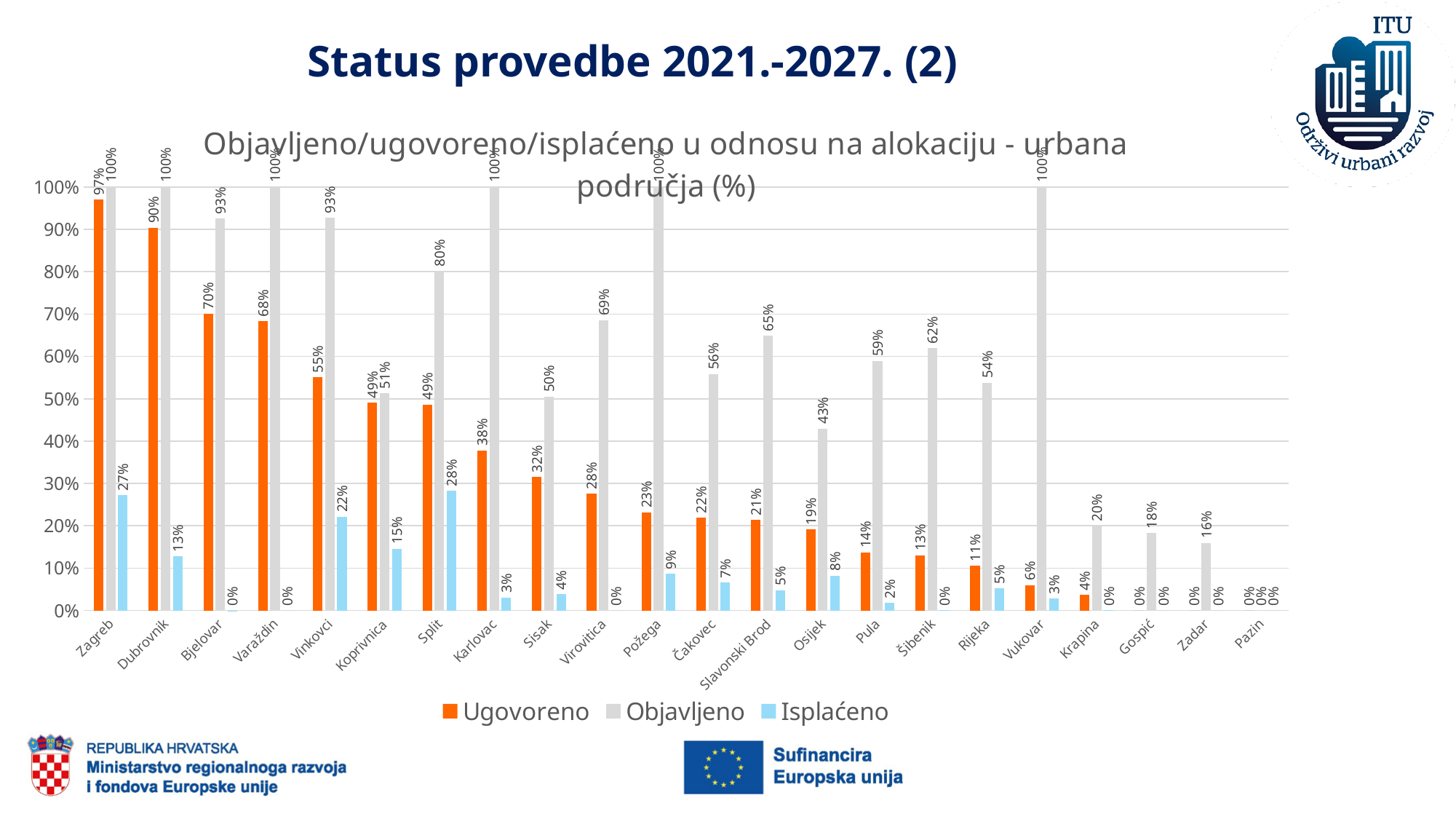
How many cities are shown on the x axis? 22 Which colour represents the Isplaćeno series? Light blue How many series does the legend list? 3 What is the Ugovoreno value for Zagreb? 97% Which is larger for Koprivnica: the Ugovoreno value or the Objavljeno value? Objavljeno What kind of chart is shown on the slide? Bar chart What is the difference between the Objavljeno and Ugovoreno values for Vukovar? 94% Which city has the highest Isplaćeno value? Split Which city has the highest Ugovoreno value? Zagreb What is the Isplaćeno value for Split? 28% Do the Ugovoreno values generally rise or fall from left to right along the x axis? Fall What is the Objavljeno value for Slavonski Brod? 65%